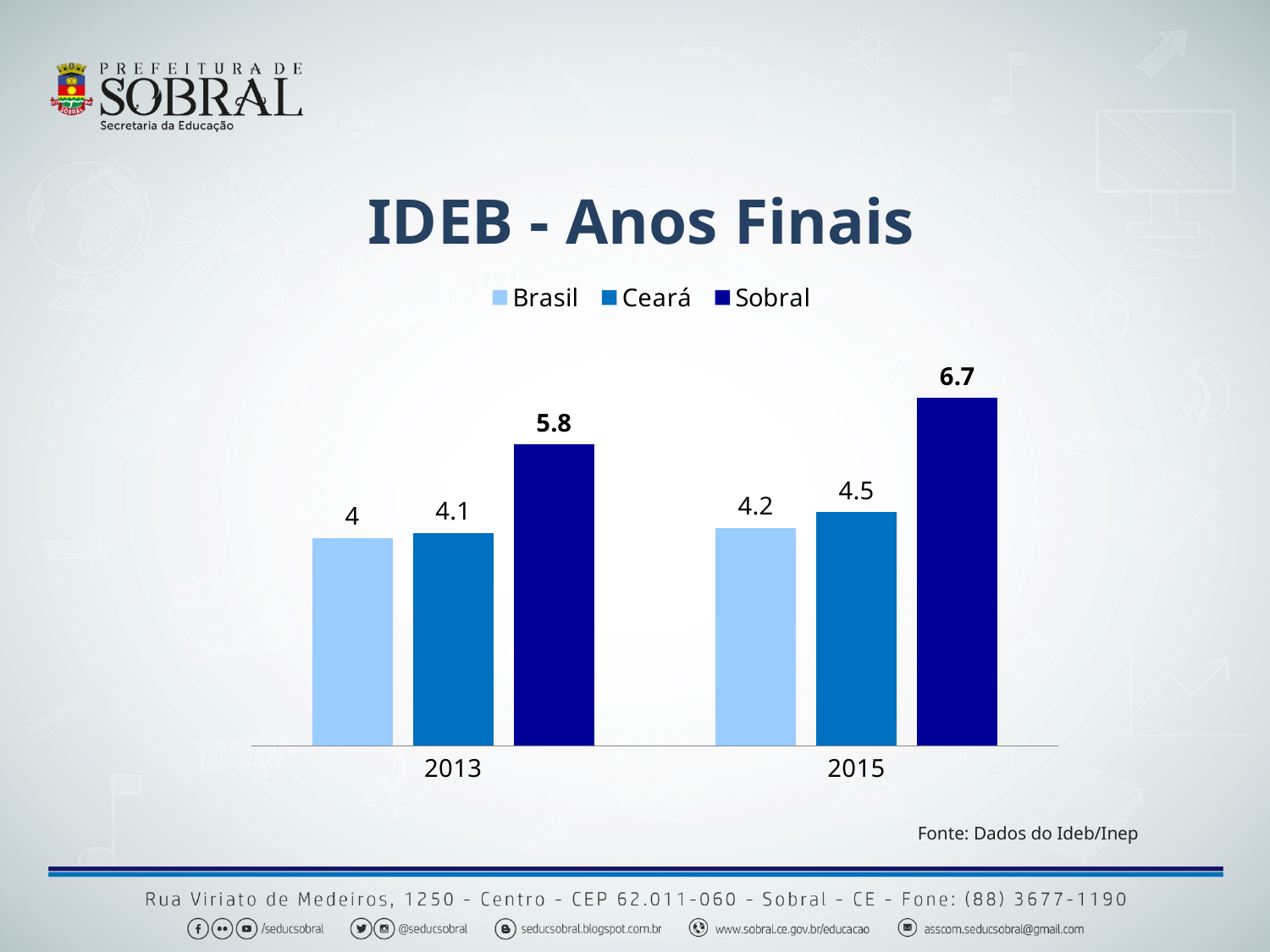
What is the difference between Sobral and Brasil in 2015? 2.5 What kind of chart is shown on the slide? Bar chart What is the value for Sobral in 2015? 6.7 Does the value for Sobral rise or fall from 2013 to 2015? Rise Which series has the highest value in 2015? Sobral What is the difference between Sobral's value in 2015 and in 2013? 0.9 What is the value for Brasil in 2013? 4 Which is larger, Ceará in 2013 or Brasil in 2015? Brasil in 2015 What is the value for Ceará in 2013? 4.1 What is the value for Ceará in 2015? 4.5 Which series has the lowest value in 2013? Brasil How many series does the legend list? 3